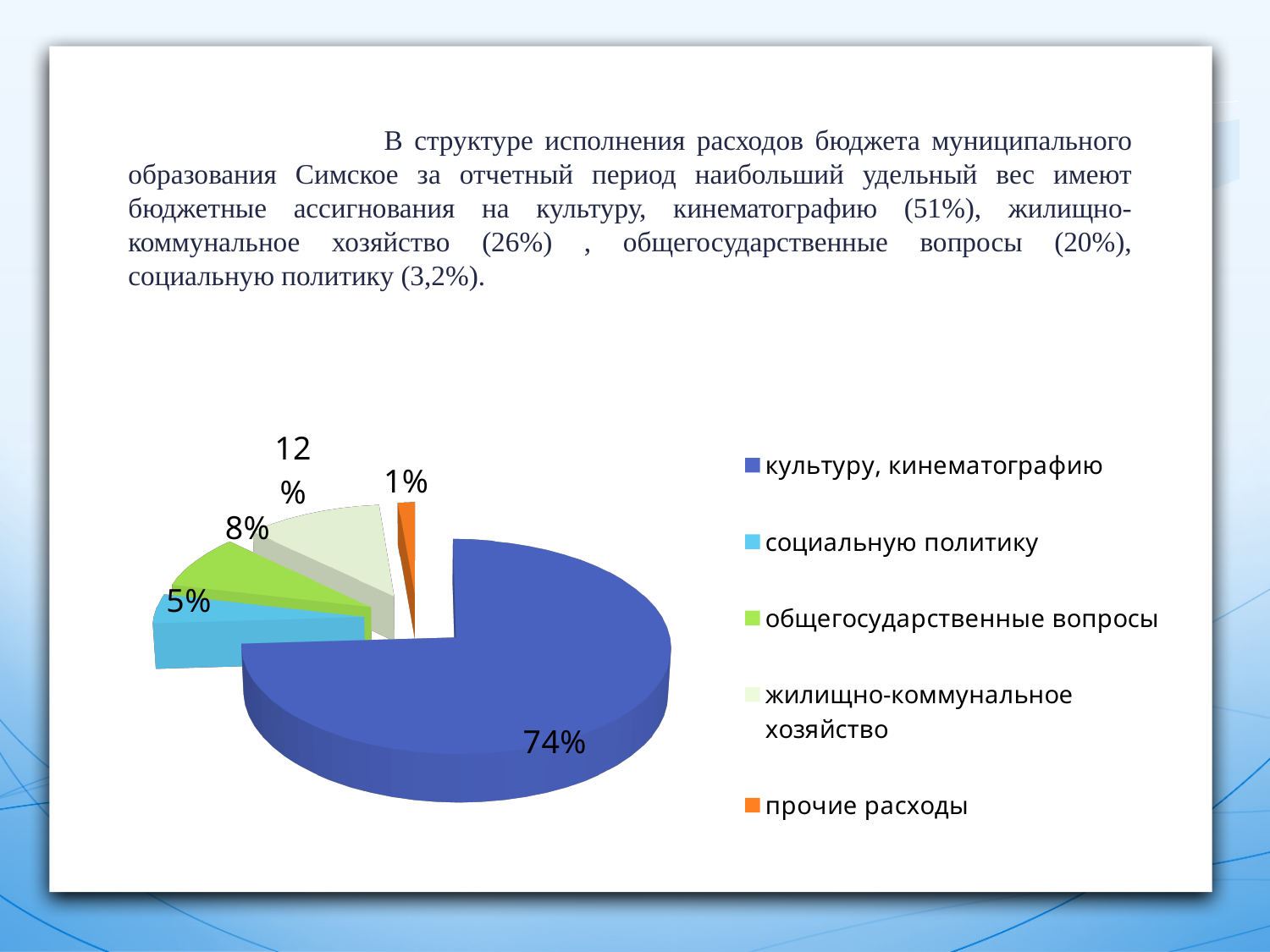
What colour is the slice for прочие расходы? orange Which slice is larger: общегосударственные вопросы or социальную политику? общегосударственные вопросы What share of the pie does жилищно-коммунальное хозяйство have? 12% How many slices does the pie chart have? 5 Which category has the largest slice of the pie? культуру, кинематографию What share of the pie does культуру, кинематографию have? 74% What is the difference in percentage points between the slices for культуру, кинематографию and жилищно-коммунальное хозяйство? 62 What share of the pie does прочие расходы have? 1% Which category has the smallest slice of the pie? прочие расходы What kind of chart is shown on the slide? pie chart